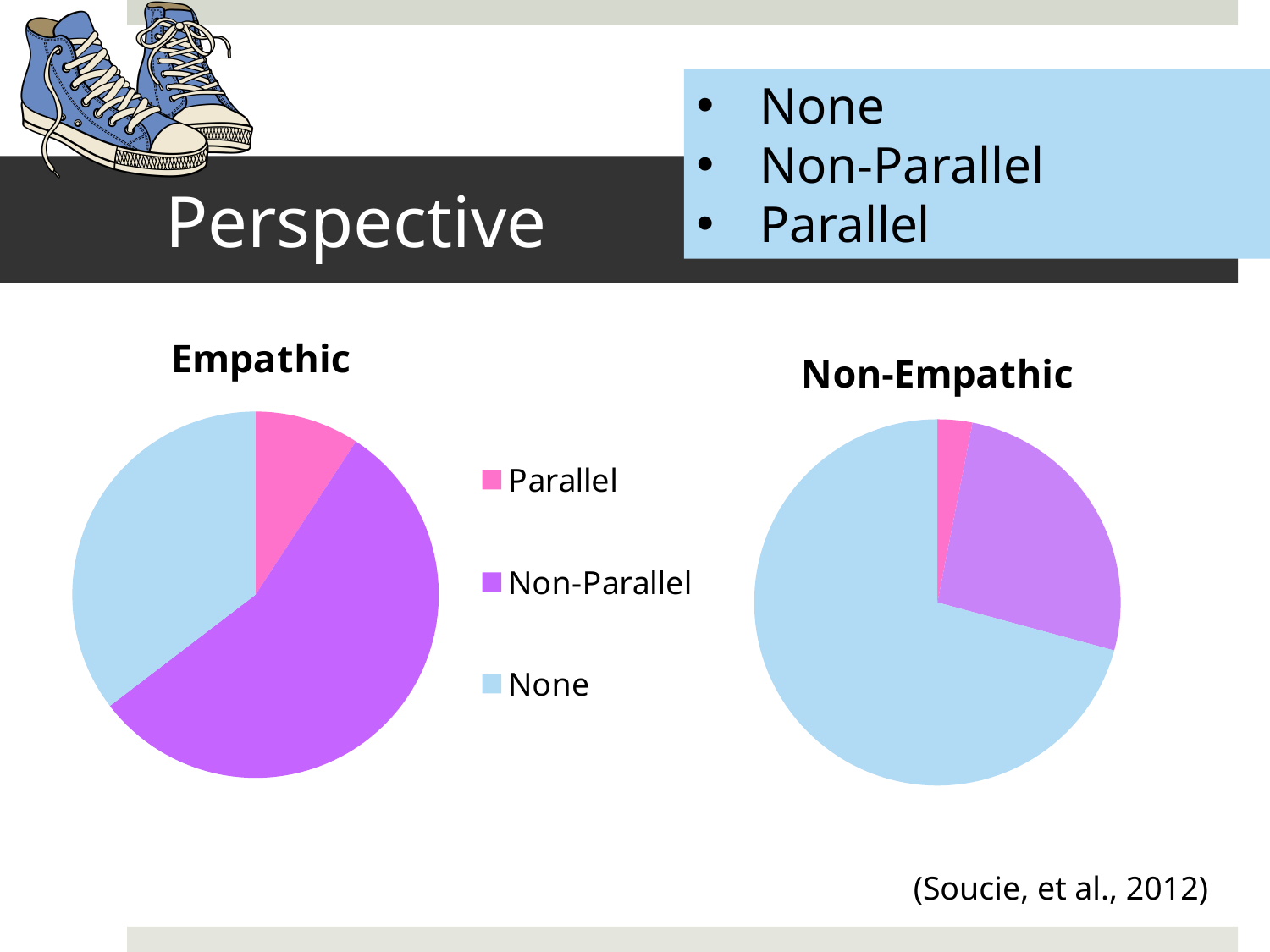
Which colour represents Parallel in the pie charts? pink What kind of chart is the Empathic chart? pie chart In the Non-Empathic pie chart, which category has the smallest slice? Parallel In the Empathic pie chart, which category has the smallest slice? Parallel In the Non-Empathic pie chart, which slice is larger, None or Non-Parallel? None How many categories does the legend list for the pie charts? 3 What kind of chart is the Non-Empathic chart? pie chart How many slices does the Empathic pie chart have? 3 In the Empathic pie chart, which slice is larger, None or Parallel? None What is the title of the pie chart on the right? Non-Empathic In the Non-Empathic pie chart, which category has the largest slice? None In the Empathic pie chart, which category has the largest slice? Non-Parallel